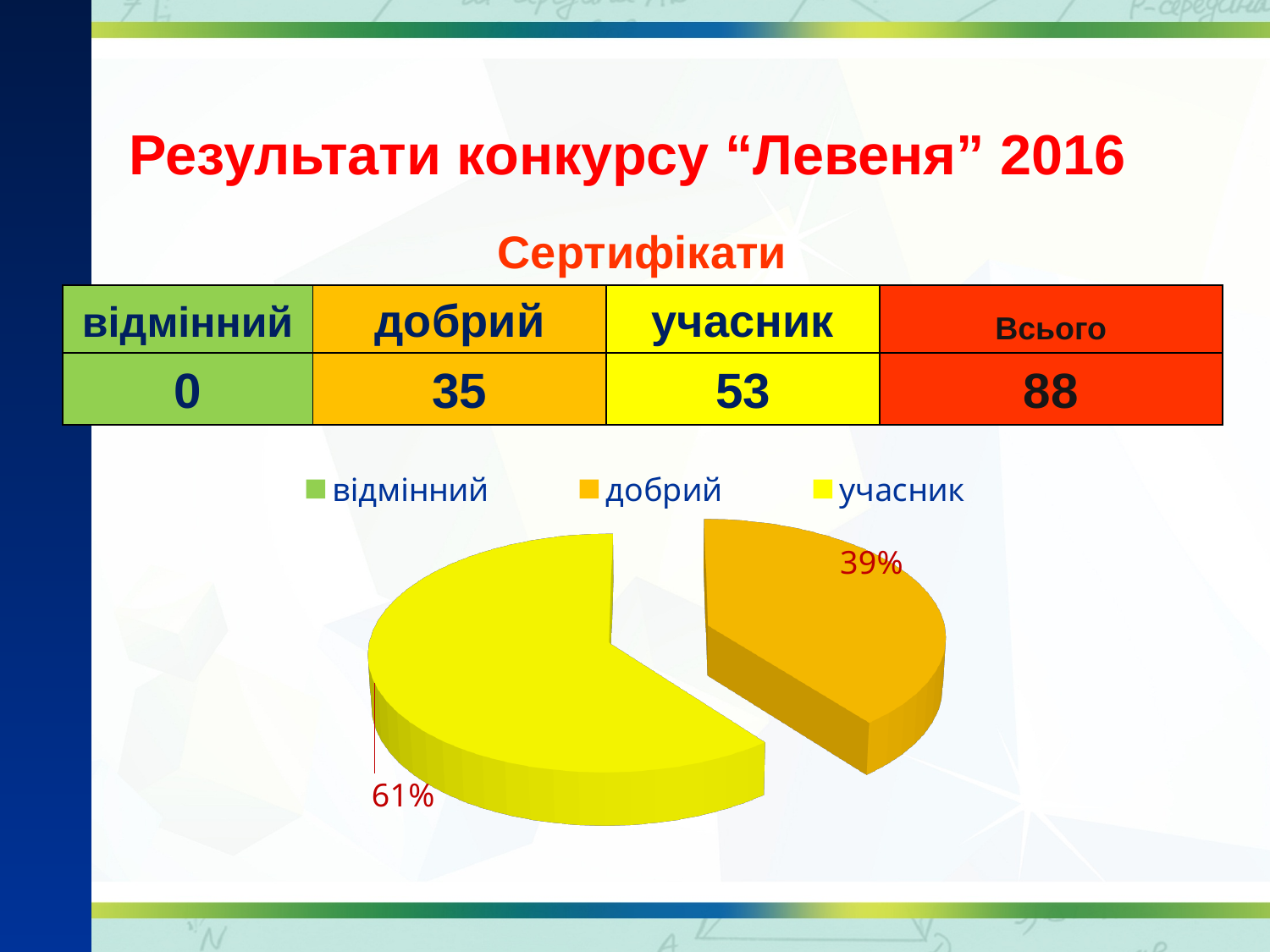
How many slices are visibly drawn in the pie chart? 2 Which slice is larger, "добрий" or "учасник"? учасник How many categories does the legend of the pie chart list? 3 What colour is the "учасник" slice in the pie chart? yellow Is the share for "добрий" greater or less than 50%? less What share of the pie does the "учасник" slice represent? 61% What share of the pie does the "добрий" slice represent? 39% What kind of chart is shown on the slide? pie chart Which category has the largest slice of the pie? учасник Which legend entry is shown in green? відмінний By how many percentage points does the "учасник" share exceed the "добрий" share? 22 percentage points